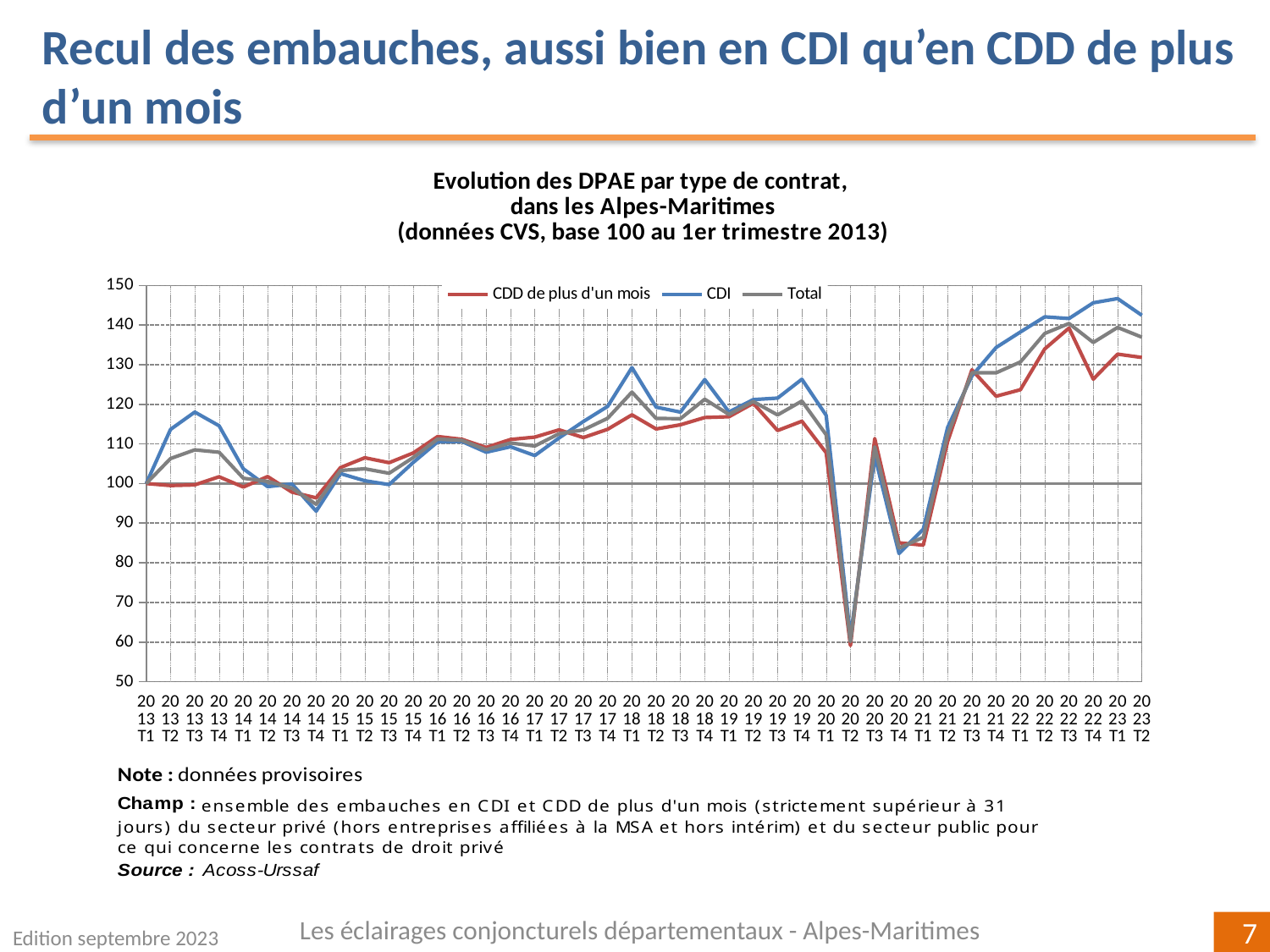
At 2023 T2, which is higher: CDI or CDD de plus d'un mois? CDI Is the value for CDI at 2023 T1 greater or less than 140? greater Which series has the highest value at 2023 T2? CDI What kind of chart is shown on the slide? line chart How many quarterly points are plotted along the x axis? 42 Is the value for CDD de plus d'un mois at 2023 T2 greater or less than 120? greater Is the value for CDI at 2020 T2 greater or less than 70? less Which colour is used for the CDI series? blue Do the three series rise or fall between 2023 T1 and 2023 T2? fall What is the value of the Total series at 2013 T1? 100 How many series does the legend list? 3